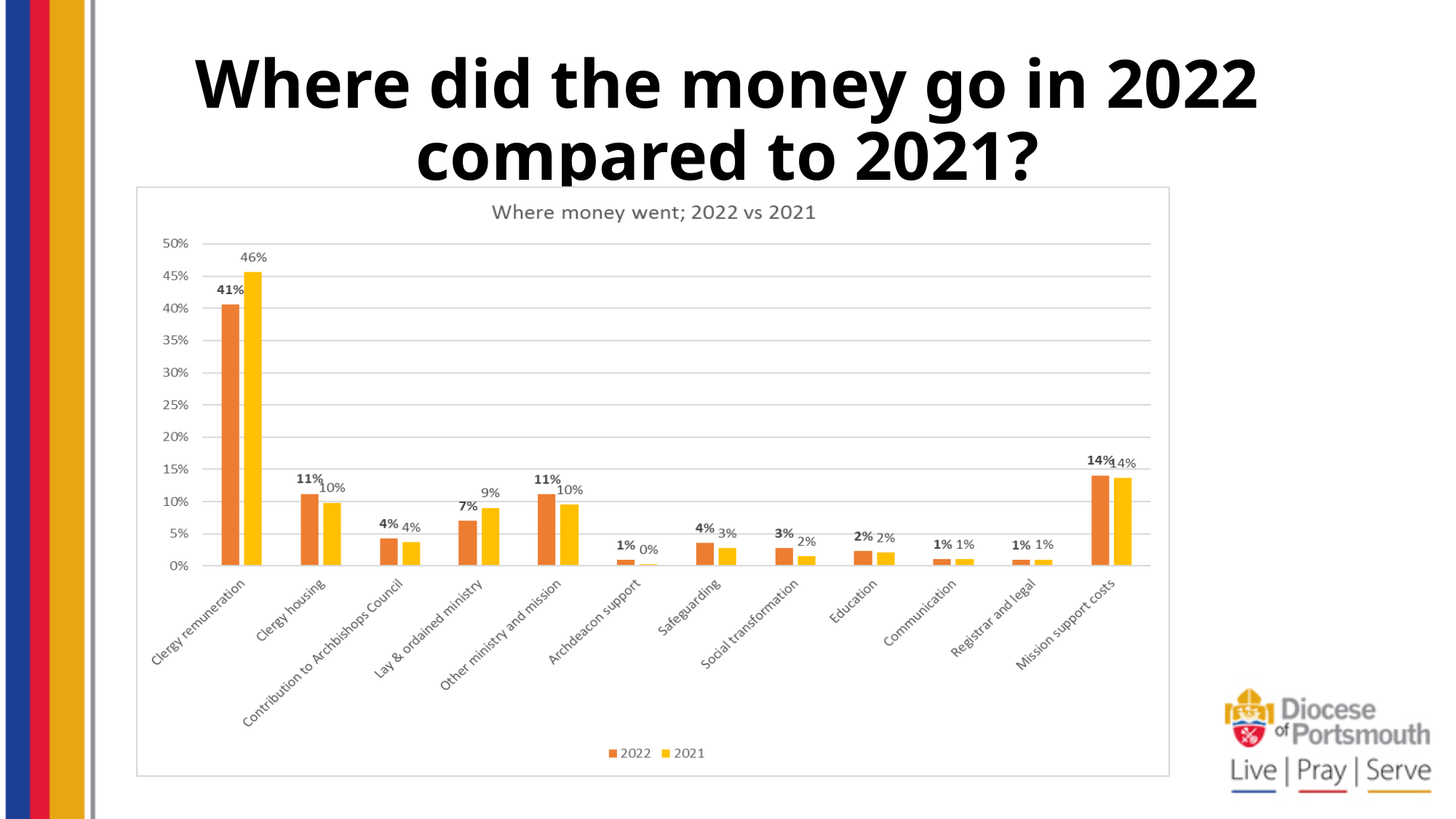
What was the 2022 value for Clergy remuneration? 41% What was the 2022 value for Mission support costs? 14% What kind of chart is shown on the slide? Bar chart How many categories are shown on the x axis? 12 Which category has the highest 2022 value? Clergy remuneration What is the title of the chart? Where money went; 2022 vs 2021 How many series does the legend list? 2 What was the 2021 value for Clergy remuneration? 46% What is the difference between the 2021 and 2022 values for Clergy remuneration? 5% What was the 2021 value for Lay & ordained ministry? 9% Which is larger for Lay & ordained ministry, the 2022 value or the 2021 value? 2021 Which category has the lowest 2021 value? Archdeacon support